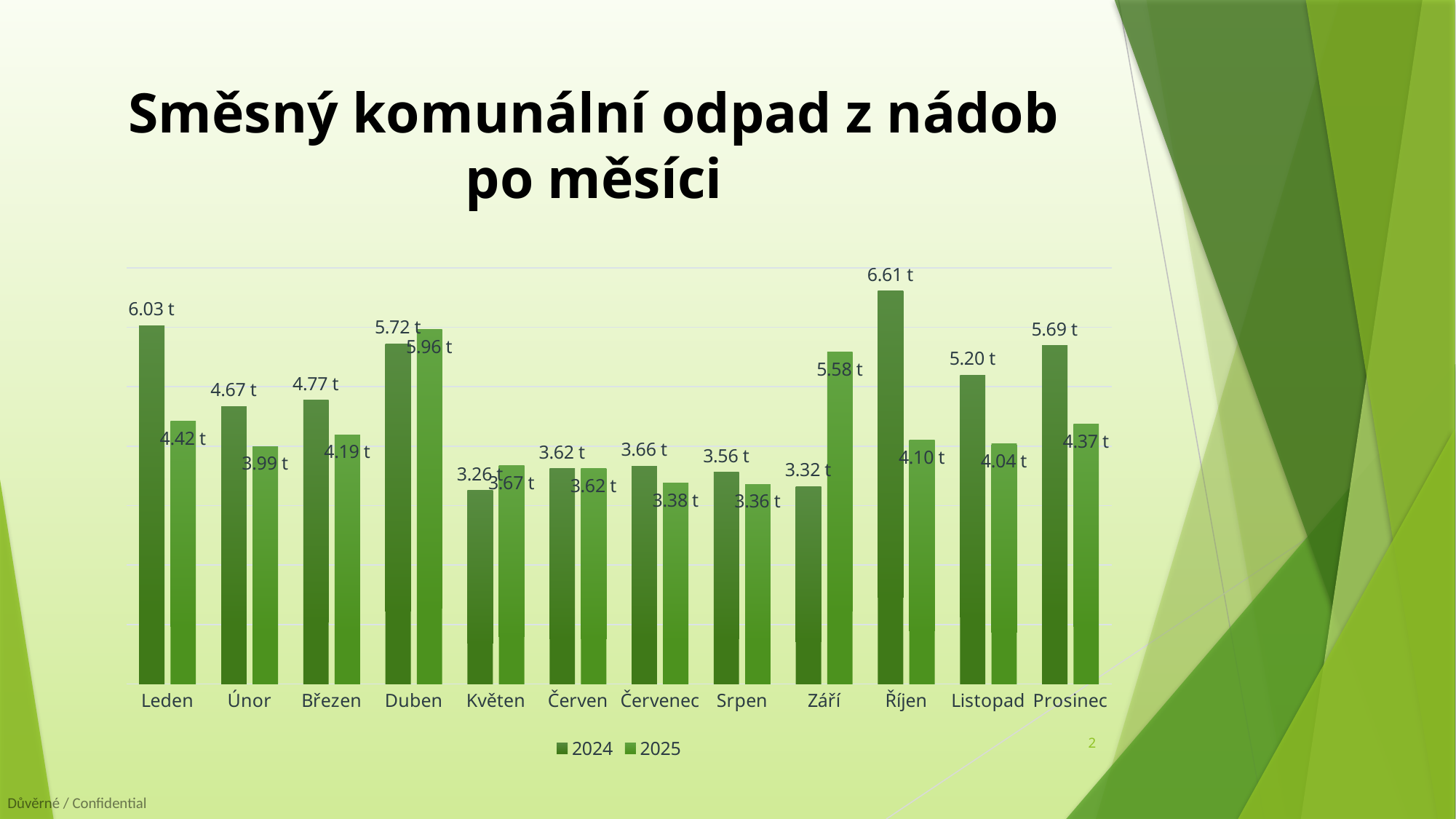
Which month has the lowest 2024 value? Květen Which is larger for Září, the 2024 value or the 2025 value? 2025 What is the 2024 value for Leden? 6.03 t How many series does the legend list? 2 Which month has the lowest 2025 value? Srpen How many months are shown on the x axis? 12 What is the 2025 value for Duben? 5.96 t Which month has the highest 2024 value? Říjen What is the title of the chart on the slide? Směsný komunální odpad z nádob po měsíci What is the 2025 value for Září? 5.58 t What is the difference between the 2024 and 2025 values for Říjen? 2.51 t What kind of chart is shown on the slide? bar chart